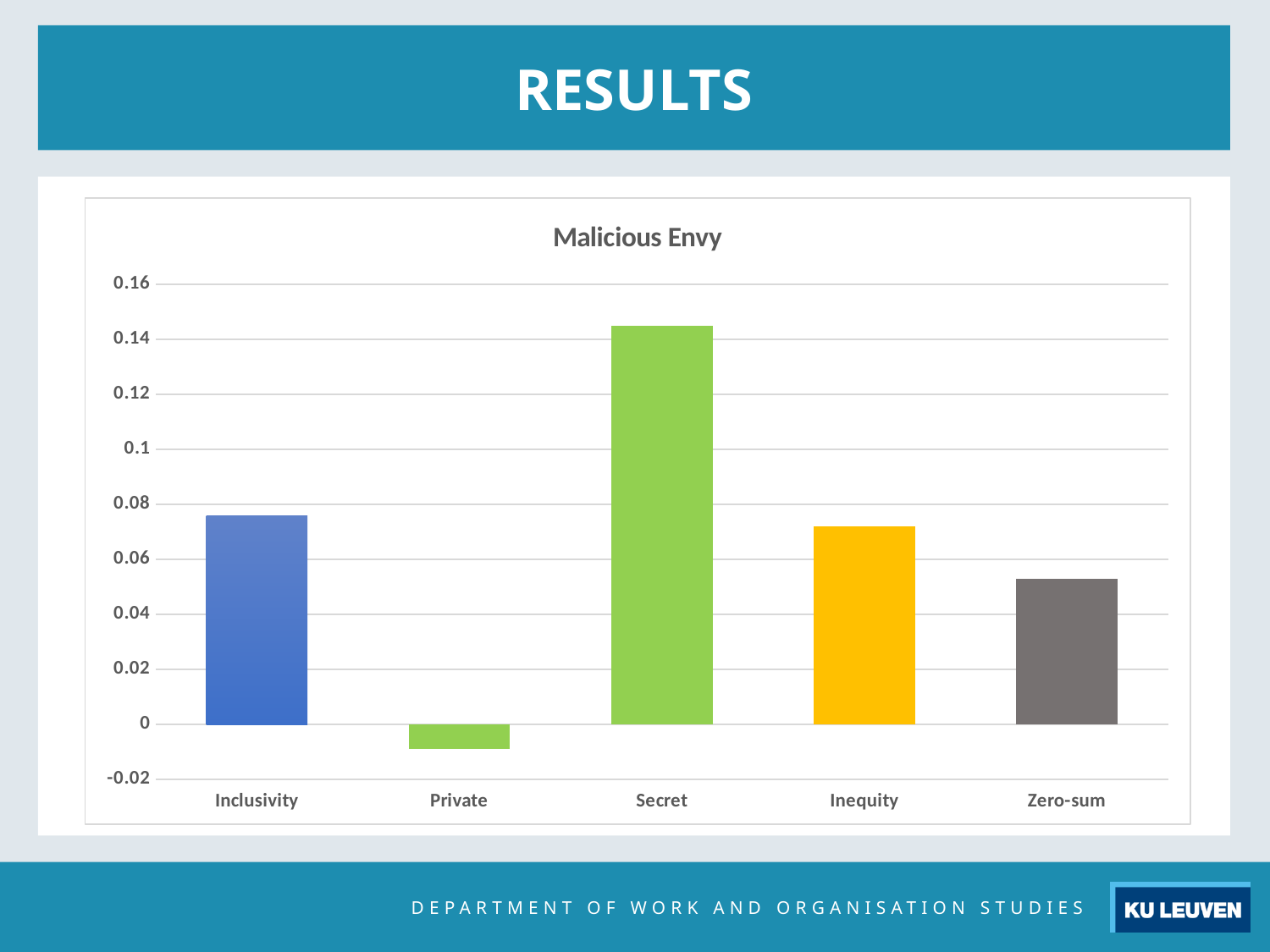
Is the value for Secret greater or less than 0.12? greater Which category is the only one with a negative value? Private Which has the larger value, Private or Inequity? Inequity Is the value for Inequity greater or less than 0.08? less Which has the larger value, Secret or Zero-sum? Secret Which category has the lowest value in the Malicious Envy chart? Private What kind of chart is shown on the slide? bar chart Which category has the highest value in the Malicious Envy chart? Secret What is the title of the chart? Malicious Envy Is the value for Inclusivity greater or less than 0.06? greater How many categories are shown on the x axis of the chart? 5